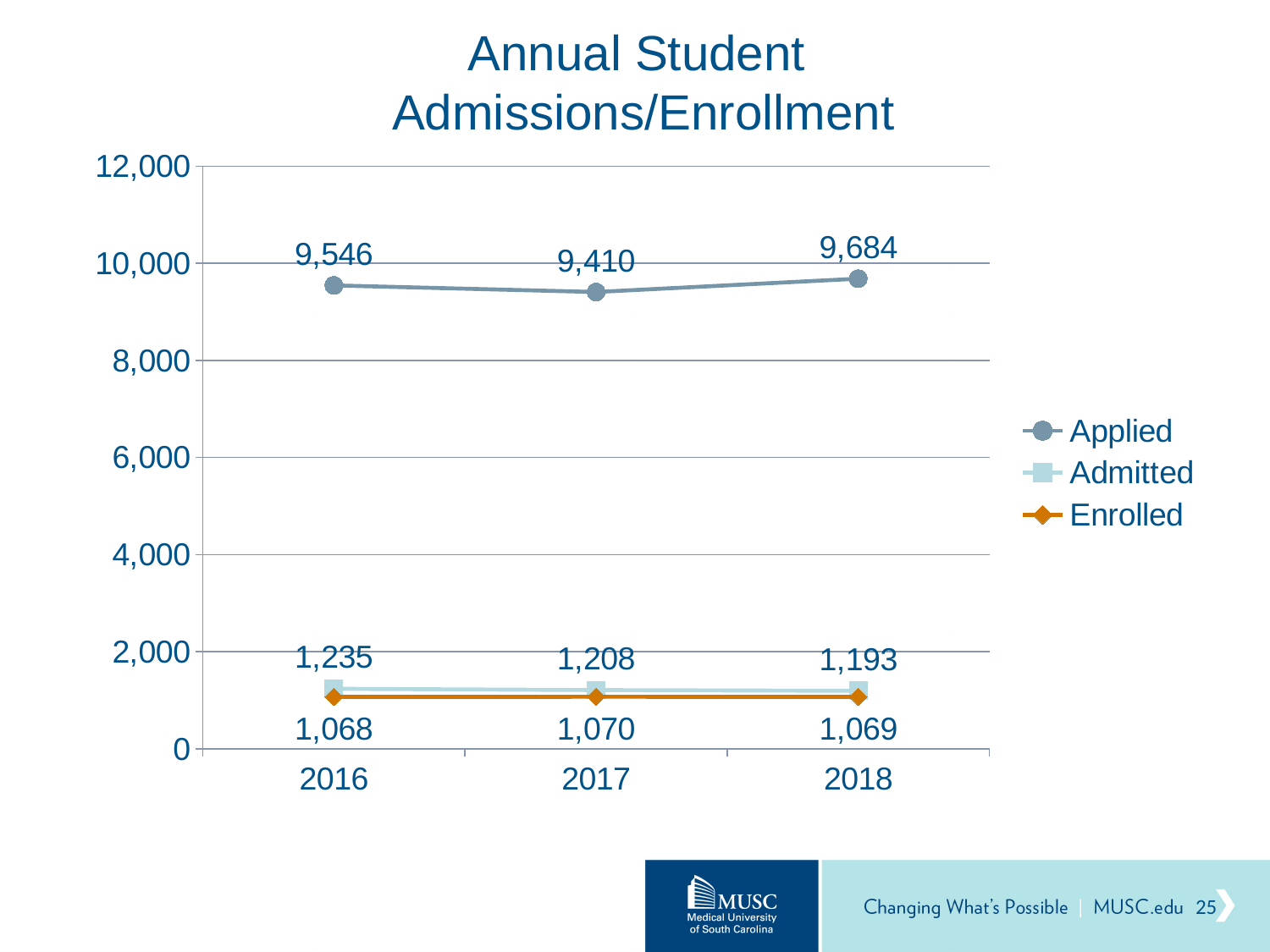
How many years are shown on the x axis? 3 What is the difference between Applied in 2018 and Applied in 2017? 274 Is the value for Applied in 2018 greater or less than 10,000? less What kind of chart is shown on the slide? line chart How many series does the legend list? 3 What is the value for Admitted in 2016? 1,235 What is the difference between Admitted and Enrolled in 2016? 167 In which year was the Admitted value lowest? 2018 What is the value for Applied in 2017? 9,410 Which is larger, Applied in 2016 or Applied in 2017? Applied in 2016 What is the value for Enrolled in 2018? 1,069 In which year was the Applied value highest? 2018